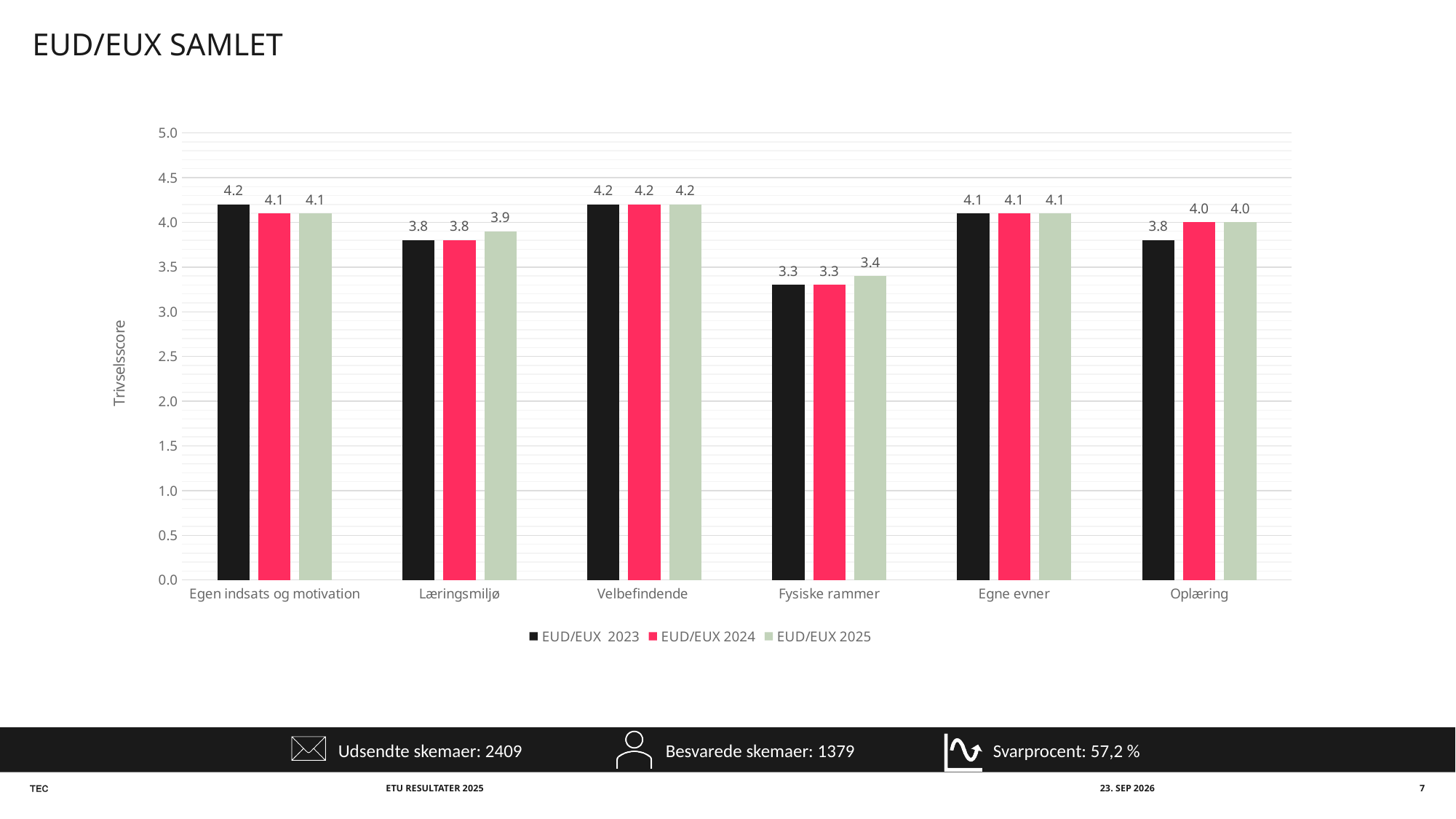
What is the label of the y axis? Trivselsscore Is the value for Fysiske rammer in the EUD/EUX 2023 series greater or less than 3.5? less What is the difference between the EUD/EUX 2025 and EUD/EUX 2023 values for Oplæring? 0.2 What is the value for Oplæring in the EUD/EUX 2024 series? 4.0 What is the value for Egen indsats og motivation in the EUD/EUX 2023 series? 4.2 What is the value for Fysiske rammer in the EUD/EUX 2025 series? 3.4 How many series does the legend list? 3 Which category has the highest value in the EUD/EUX 2024 series? Velbefindende What kind of chart is shown on the slide? bar chart Which category has the lowest value in the EUD/EUX 2025 series? Fysiske rammer Which is larger for Læringsmiljø: the EUD/EUX 2023 value or the EUD/EUX 2025 value? EUD/EUX 2025 How many categories are shown on the x axis? 6